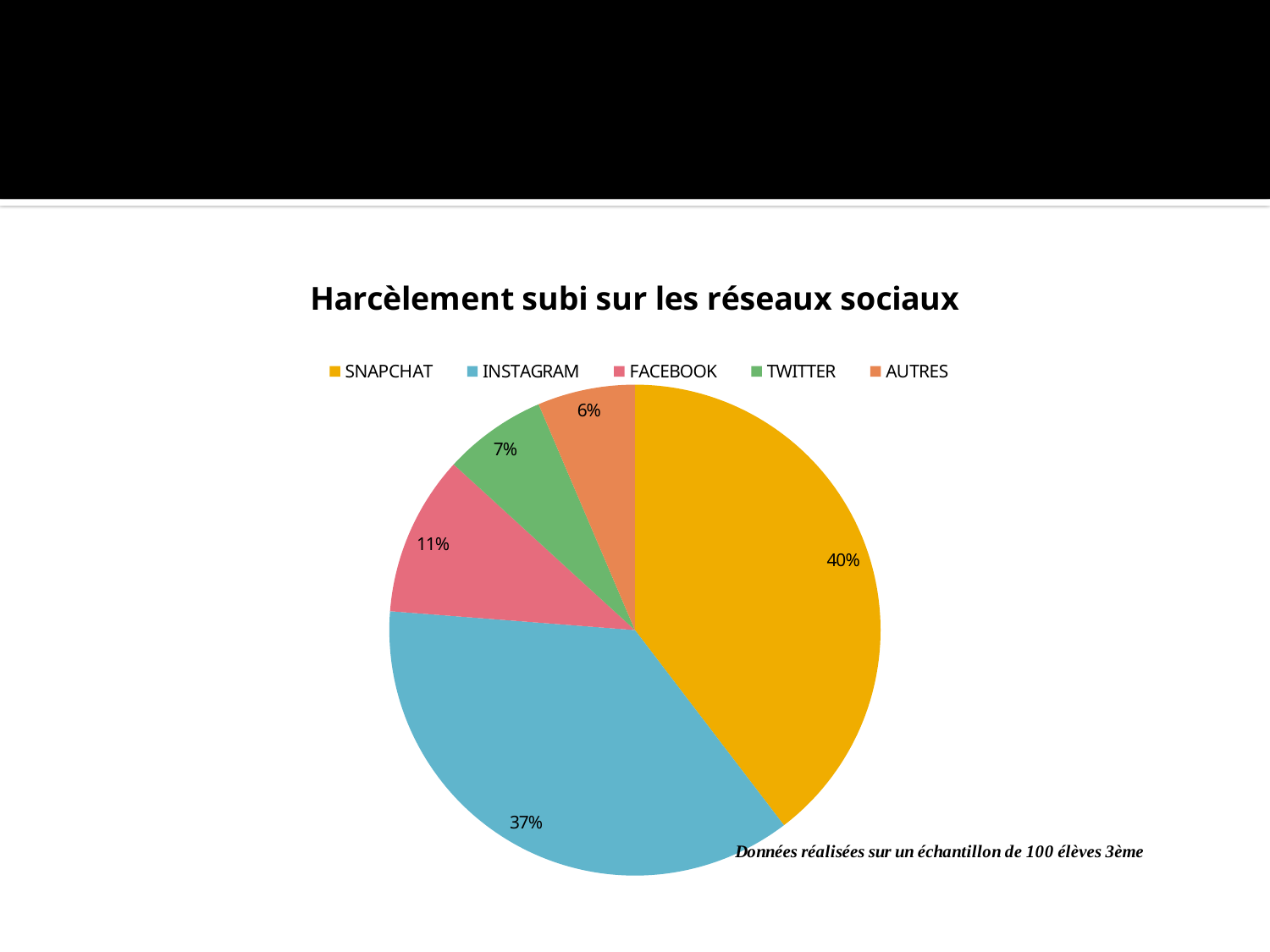
What percentage of the pie does FACEBOOK represent? 11% What percentage of the pie does TWITTER represent? 7% What is the title of the chart? Harcèlement subi sur les réseaux sociaux What percentage of the pie does SNAPCHAT represent? 40% What percentage of the pie does AUTRES represent? 6% What type of chart is shown on the slide? pie chart What percentage of the pie does INSTAGRAM represent? 37% How many categories does the legend list? 5 Which category has the largest share of the pie? SNAPCHAT What is the difference in percentage points between SNAPCHAT and INSTAGRAM? 3 Which is larger, the share for FACEBOOK or the share for TWITTER? FACEBOOK Which category has the smallest share of the pie? AUTRES